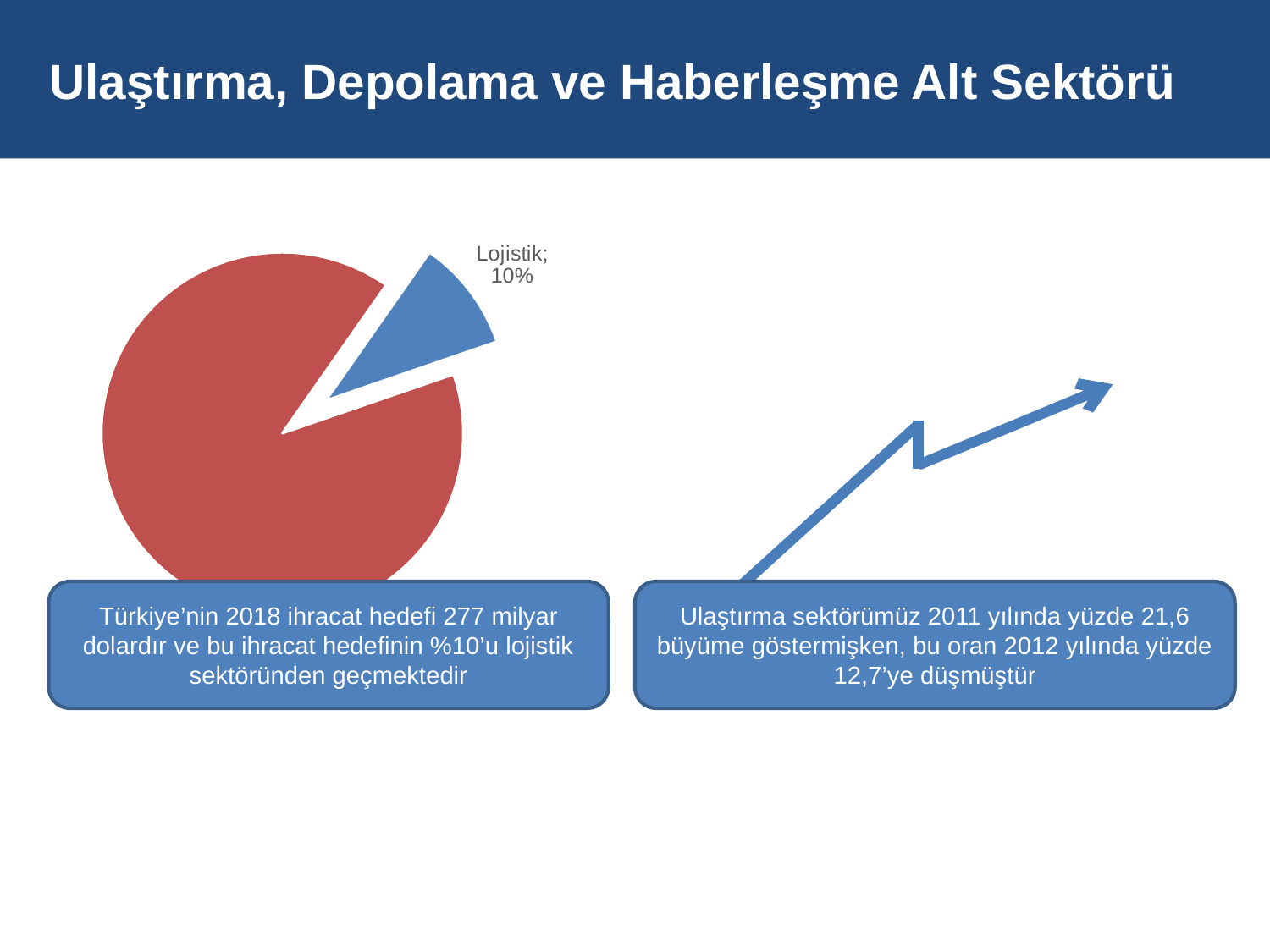
What kind of chart is shown on the left of the slide? pie chart In the pie chart, what percentage is shown for Lojistik? 10% Is the Lojistik slice larger or smaller than the red slice in the pie chart? smaller How many slices does the pie chart have? 2 Which slice of the pie chart is pulled out (exploded) from the rest of the pie? Lojistik Is the Lojistik slice the largest or the smallest slice of the pie chart? smallest What colour is the Lojistik slice in the pie chart? blue What share of the pie does the Lojistik slice represent? 10%